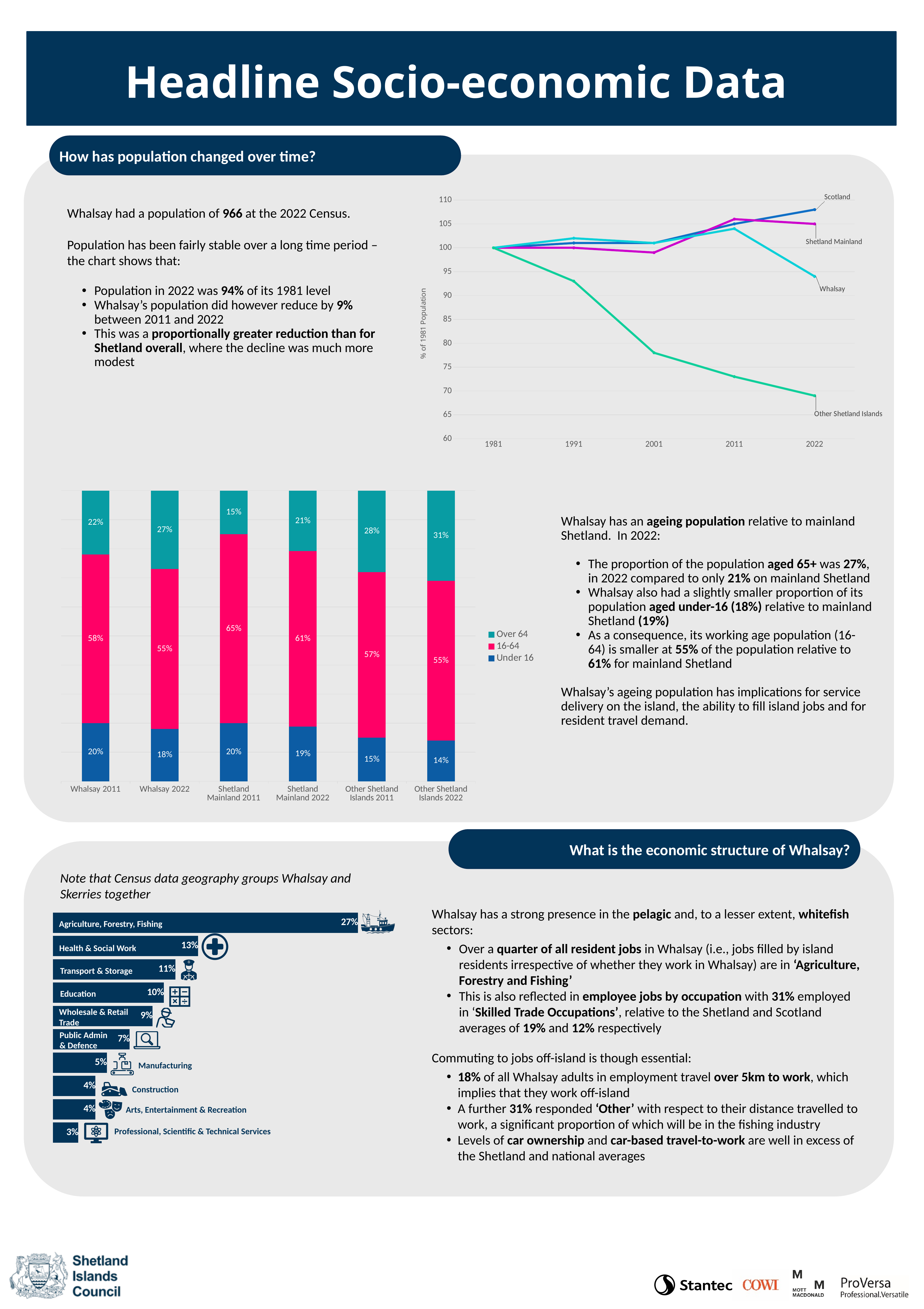
In the stacked bar chart of age structure, which category has the lowest Under 16 share? Other Shetland Islands 2022 In the stacked bar chart of age structure, what percentage of Whalsay's 2022 population was Over 64? 27% In the horizontal bar chart of economic sectors, what share is shown for Transport & Storage? 11% In the line chart of population as % of 1981, is the value for Other Shetland Islands in 2001 greater or less than 80? less In the stacked bar chart of age structure, how many percentage points higher is the Over 64 share for Whalsay 2022 than for Shetland Mainland 2022? 6 percentage points In the line chart of population as % of 1981, which series is lowest in 2022? Other Shetland Islands In the stacked bar chart of age structure, which category has the highest Over 64 share? Other Shetland Islands 2022 How many sectors are shown in the horizontal bar chart of economic sectors? 10 How many series does the legend of the stacked bar chart of age structure list? 3 In the horizontal bar chart of economic sectors, which sector has the largest share? Agriculture, Forestry, Fishing In the stacked bar chart of age structure, what is the 16-64 share for Shetland Mainland 2011? 65% In the line chart of population as % of 1981, does the Other Shetland Islands line rise or fall from 1981 to 2022? fall